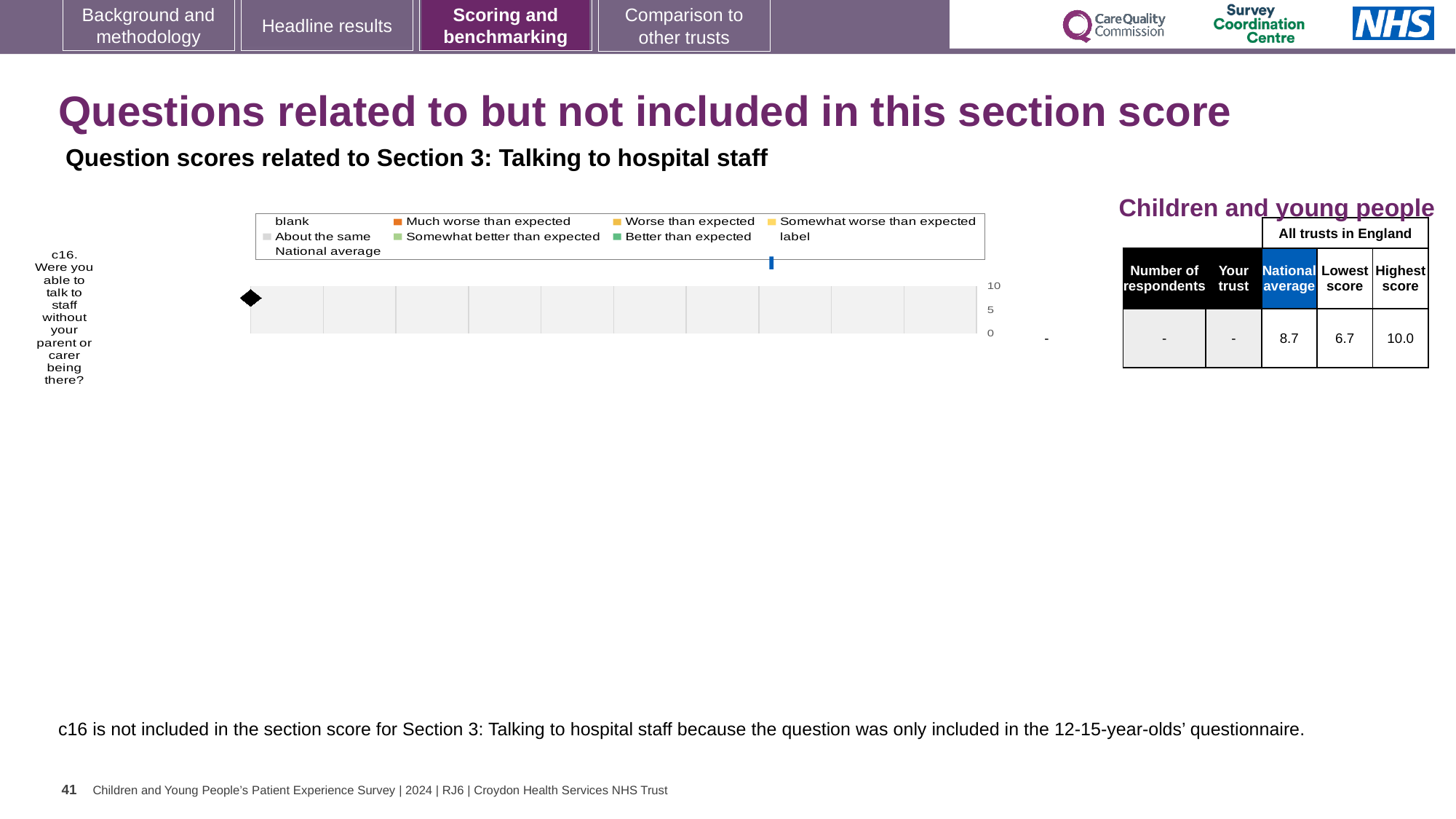
In the table next to the chart, what is the Highest score among all trusts in England for c16? 10.0 In the table next to the chart, which is larger for c16: the National average or the Lowest score? National average In the table next to the chart, what is the National average score for c16? 8.7 In the table next to the chart, what is shown for Your trust for c16? - In the table next to the chart, what is the difference between the Highest score and the Lowest score for c16? 3.3 In the table next to the chart, what is the Lowest score among all trusts in England for c16? 6.7 What kind of chart is shown on the slide for question c16? bar chart Is the National average score for c16 in the table greater or less than 5? greater Which question number is the single category on the chart? c16 What is the highest value shown on the chart's axis? 10 How many questions (categories) are plotted on the chart? 1 How many entries does the chart legend list? 9